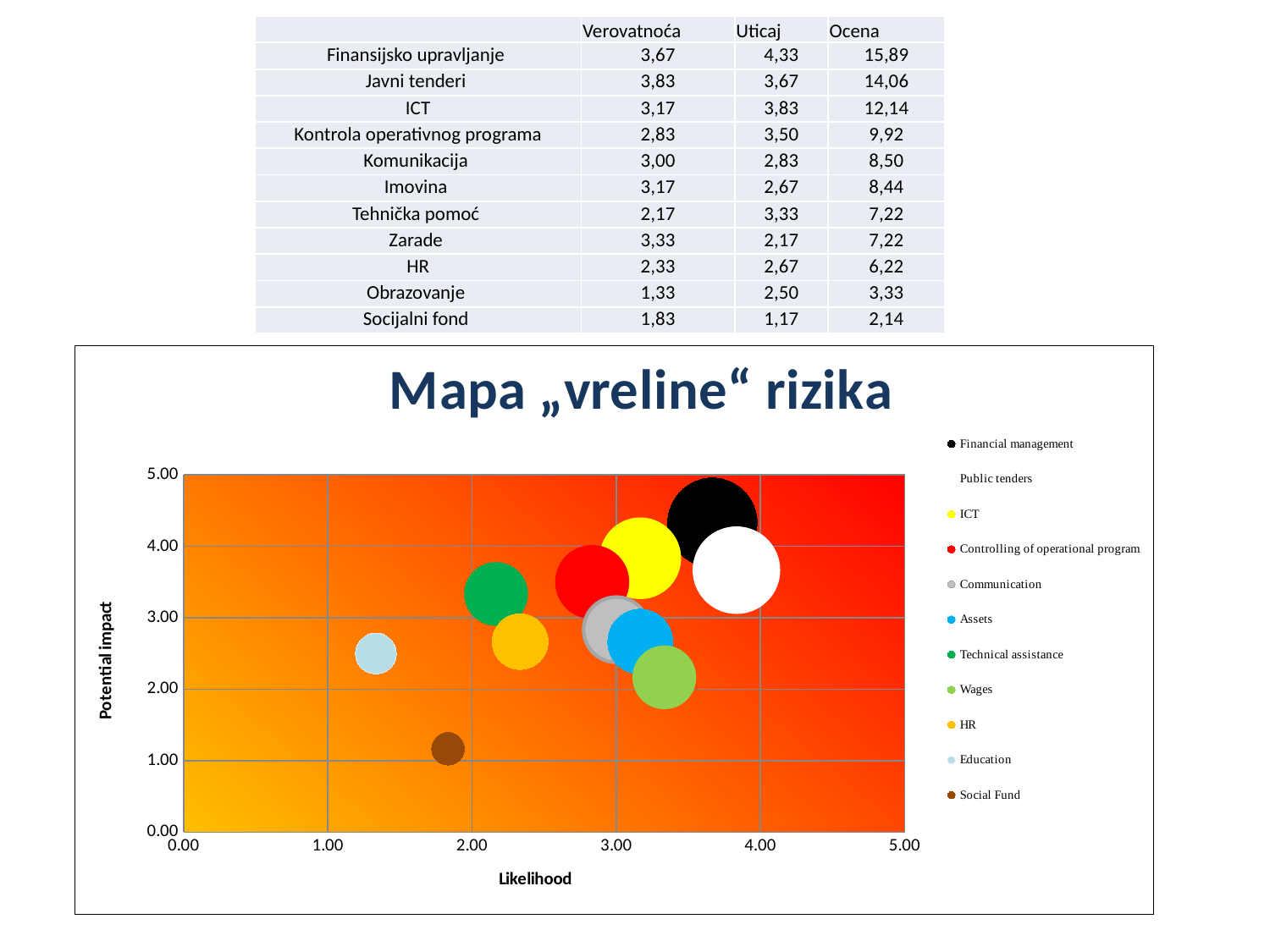
What kind of chart is shown under the title "Mapa „vreline“ rizika"? bubble chart Which series has the highest Potential impact in the chart? Financial management What is the label of the horizontal axis of the chart? Likelihood How many series does the legend of the "Mapa „vreline“ rizika" chart list? 11 Which has the higher Potential impact, Financial management or Social Fund? Financial management Which series has the lowest Likelihood in the chart? Education What is the title of the chart on the slide? Mapa „vreline“ rizika Is the Potential impact for Financial management greater or less than 4.00? greater Is the Potential impact for Technical assistance greater or less than 3.00? greater Which series has the lowest Potential impact in the chart? Social Fund Is the Likelihood for Education greater or less than 2.00? less